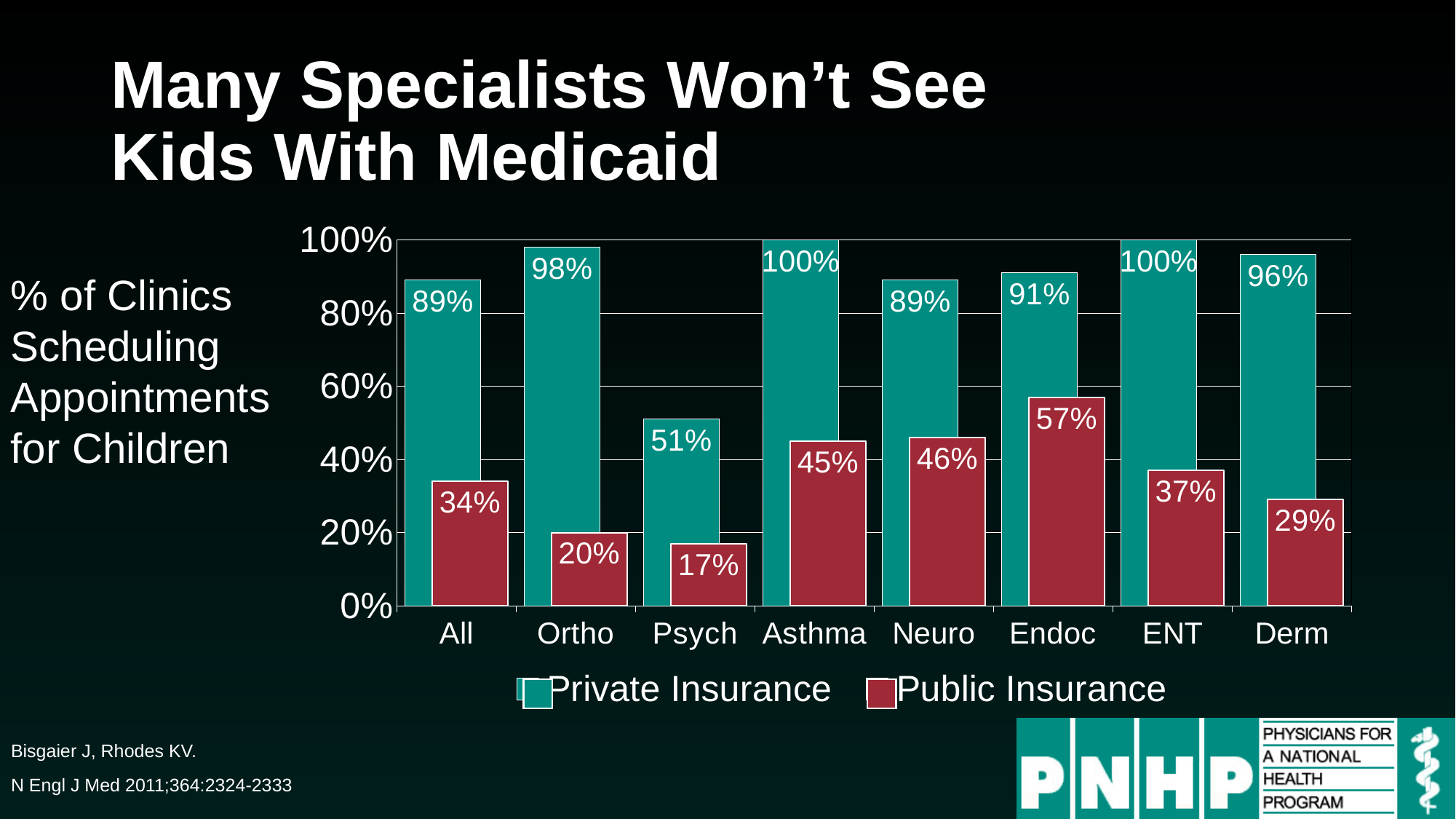
Which category has the lowest Public Insurance value? Psych What is the difference between the Private Insurance and Public Insurance values for Derm? 67% How many series does the legend list? 2 What kind of chart is shown on the slide? Bar chart What is the Private Insurance value for Ortho? 98% How many categories are shown on the x axis? 8 Which category has the lowest Private Insurance value? Psych Which is larger: the Public Insurance value for Asthma or for Neuro? Neuro What is the Public Insurance value for Endoc? 57% Which category has the highest Public Insurance value? Endoc Which series is shown in red? Public Insurance What is the Public Insurance value for Psych? 17%